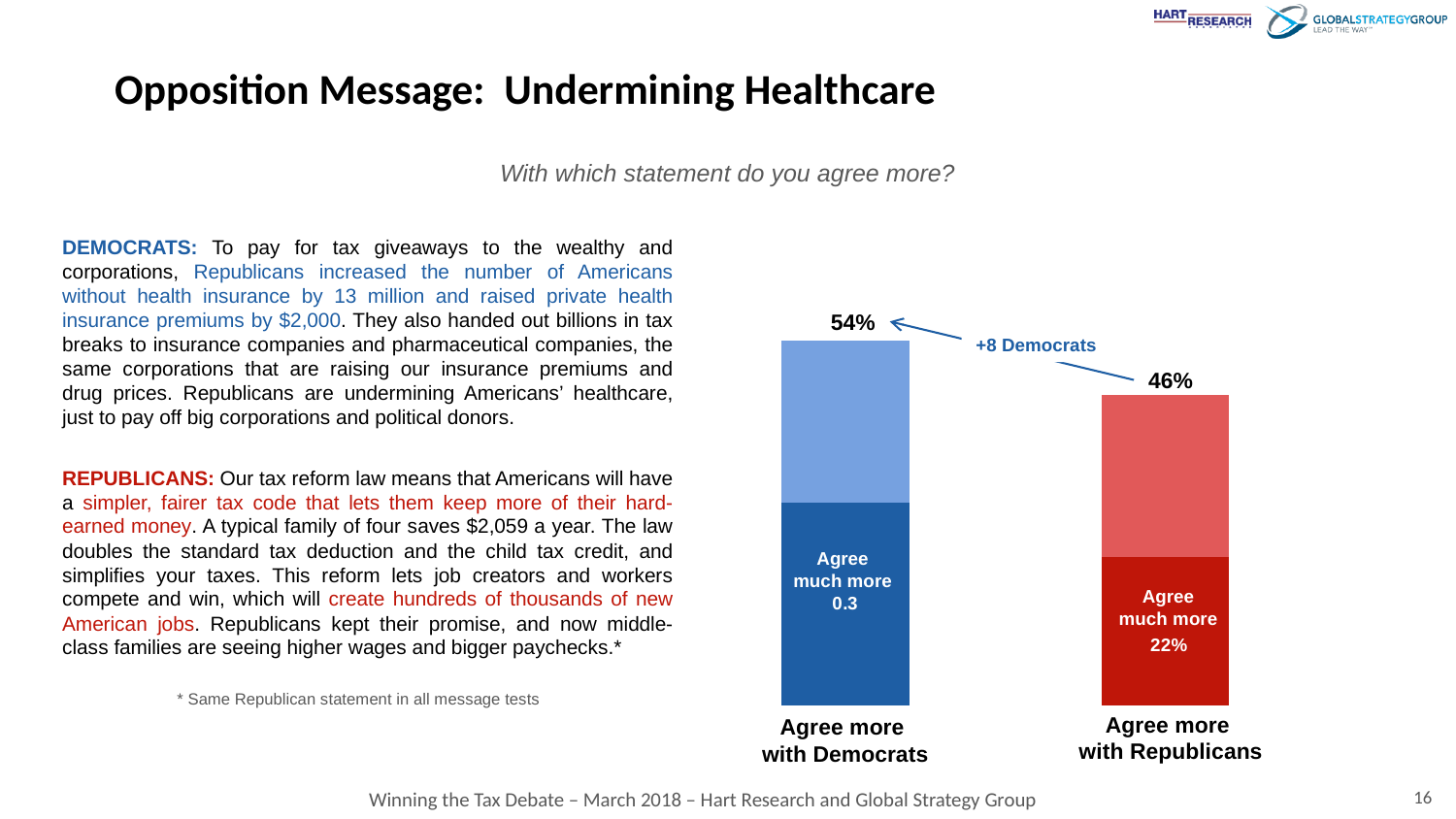
How many bars are shown in the chart? 2 What does the annotation between the two bars say? +8 Democrats What percentage of respondents agree more with Republicans? 46% Which bar has the highest total value? Agree more with Democrats Which bar has the lowest total value? Agree more with Republicans What percentage of respondents agree more with Democrats? 54% What kind of chart is shown on the slide? Stacked bar chart What is the difference between the share agreeing more with Democrats and the share agreeing more with Republicans? 8 Which is larger: the share agreeing more with Democrats or the share agreeing more with Republicans? Agree more with Democrats What colour is the 'Agree more with Republicans' bar? Red What value is printed for the 'Agree much more' segment of the Republicans bar? 22% What value is printed for the 'Agree much more' segment of the Democrats bar? 0.3